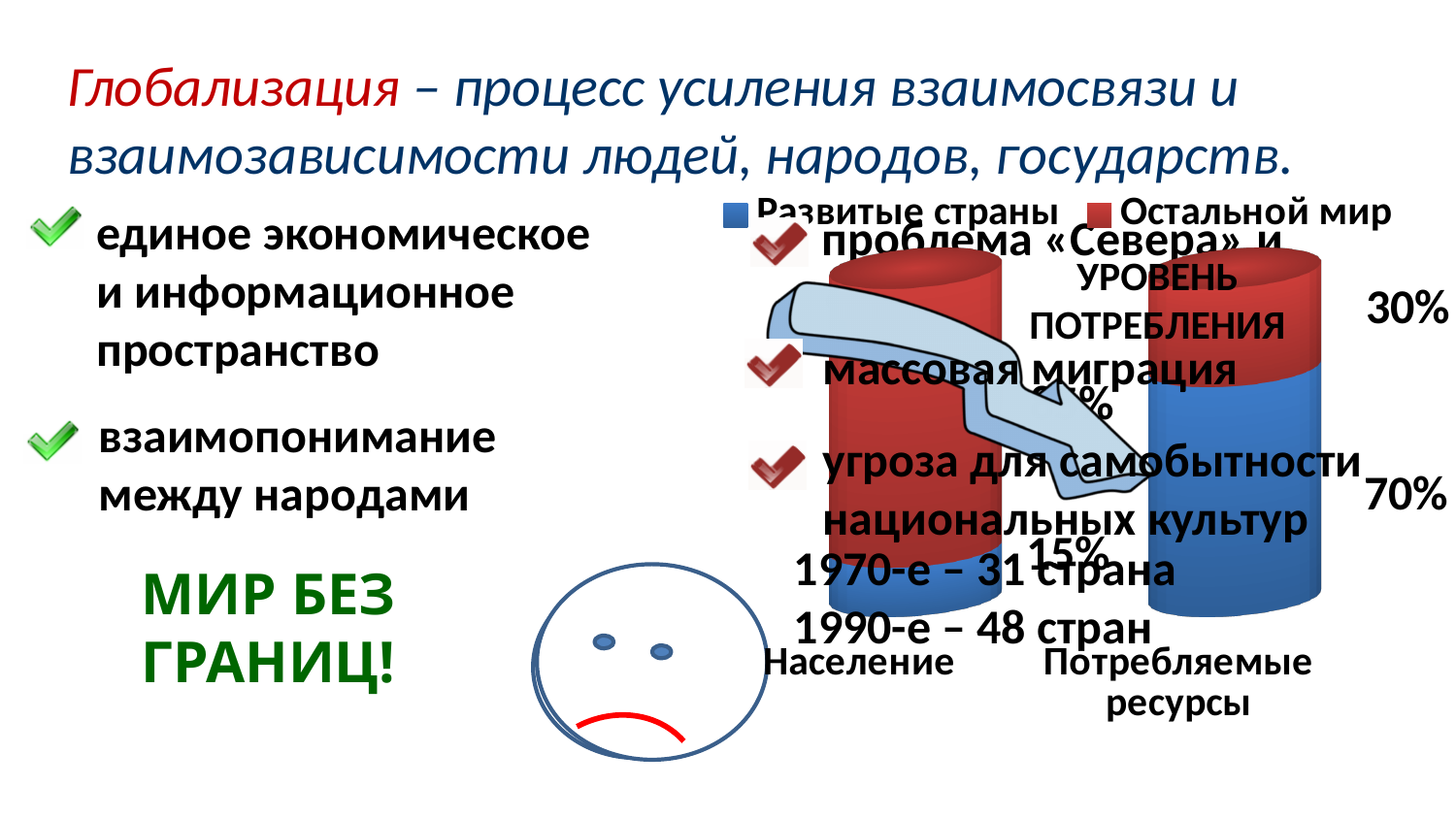
What value is shown for Развитые страны in the Потребляемые ресурсы bar? 70% Which colour represents Развитые страны in the chart legend? Blue In the Потребляемые ресурсы bar, which series has the larger value: Развитые страны or Остальной мир? Развитые страны How many categories are shown along the x axis of the chart? 2 What is the total of the Потребляемые ресурсы stacked bar? 100% How many series does the chart legend list? 2 What kind of chart is shown on the right side of the slide? Stacked bar chart What value is shown for Остальной мир in the Потребляемые ресурсы bar? 30% What is the difference between the Развитые страны and Остальной мир values in the Потребляемые ресурсы bar? 40% Is the value for Развитые страны larger in the Население bar or in the Потребляемые ресурсы bar? Потребляемые ресурсы What value is shown for Развитые страны in the Население bar? 15% What are the two categories on the x axis of the chart? Население and Потребляемые ресурсы